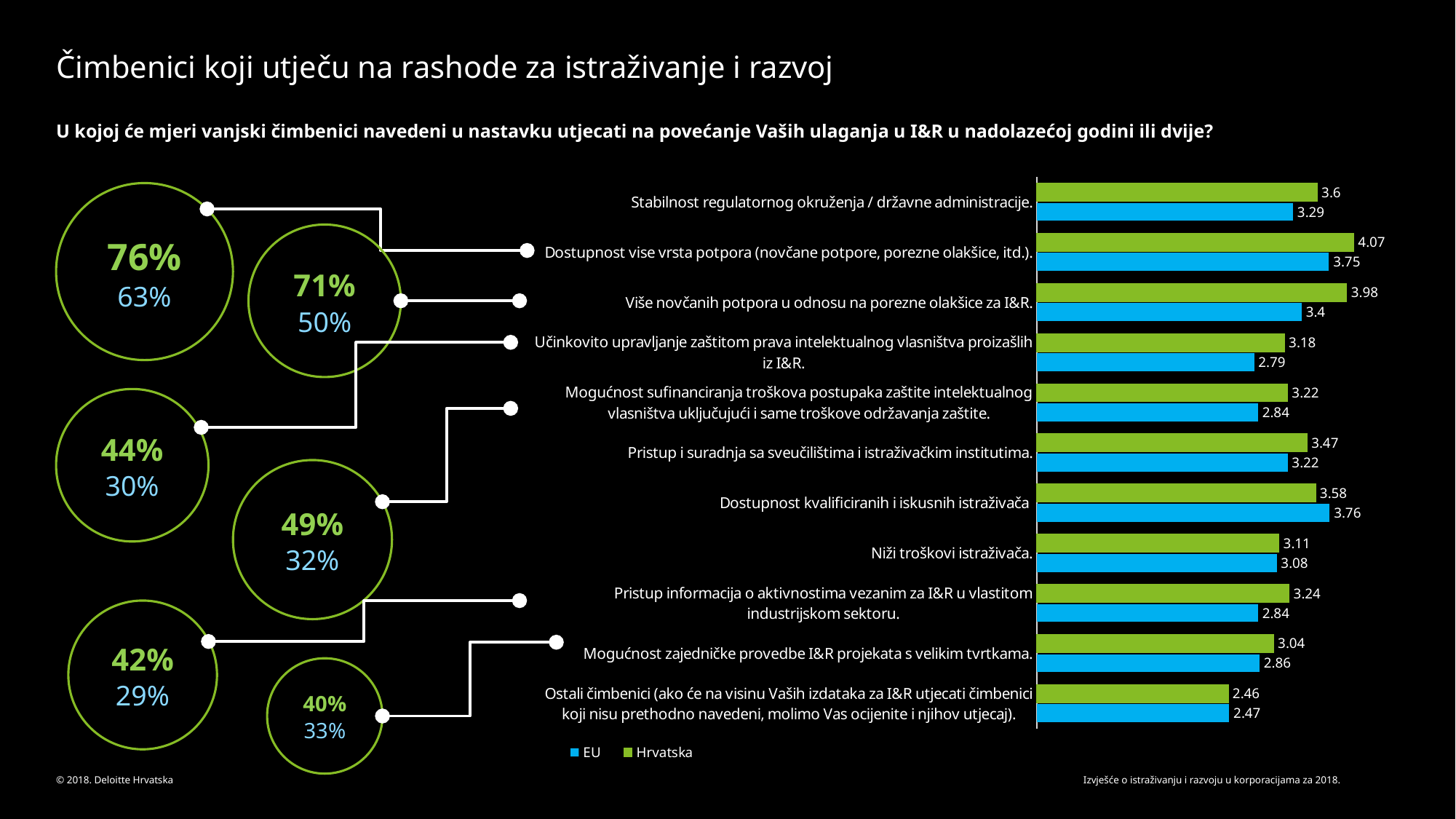
How many categories does the bar chart show? 11 Which category has the highest Hrvatska value? Dostupnost vise vrsta potpora (novčane potpore, porezne olakšice, itd.) What kind of chart is used to show the EU and Hrvatska values? Bar chart What is the Hrvatska value for "Dostupnost vise vrsta potpora (novčane potpore, porezne olakšice, itd.)"? 4.07 What is the difference between the Hrvatska and EU values for "Više novčanih potpora u odnosu na porezne olakšice za I&R"? 0.58 Which category has the lowest Hrvatska value? Ostali čimbenici What is the EU value for "Dostupnost kvalificiranih i iskusnih istraživača"? 3.76 What is the EU value for "Stabilnost regulatornog okruženja / državne administracije"? 3.29 For "Dostupnost kvalificiranih i iskusnih istraživača", which is larger, the EU value or the Hrvatska value? EU For "Učinkovito upravljanje zaštitom prava intelektualnog vlasništva proizašlih iz I&R", which is larger, the EU value or the Hrvatska value? Hrvatska Which colour represents the EU series in the bar chart? Blue How many series does the legend of the bar chart list? 2